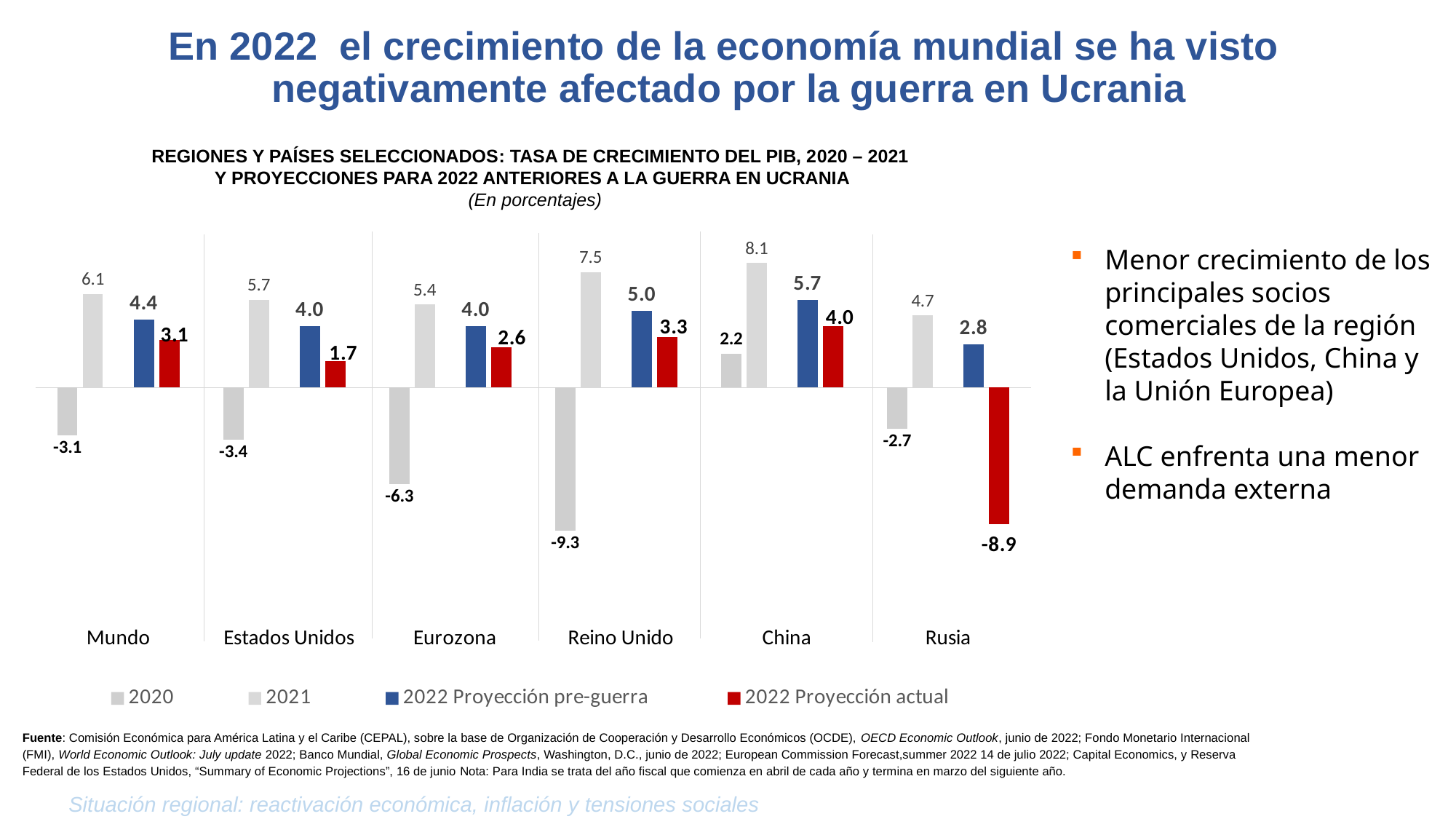
Which country or region has the highest 2021 value? China What is the 2020 value for Reino Unido? -9.3 Which series is shown in red in the legend? 2022 Proyección actual What is the 2022 Proyección actual value for Rusia? -8.9 What is the difference between the 2022 Proyección pre-guerra and the 2022 Proyección actual values for Estados Unidos? 2.3 Which country or region has the lowest 2020 value? Reino Unido Which is larger for Eurozona: the 2021 value or the 2022 Proyección actual value? 2021 How many series does the legend list? 4 How many countries or regions are shown on the x axis? 6 What type of chart is shown on the slide? Bar chart What is the 2022 Proyección pre-guerra value for Estados Unidos? 4.0 What is the 2021 value for China? 8.1